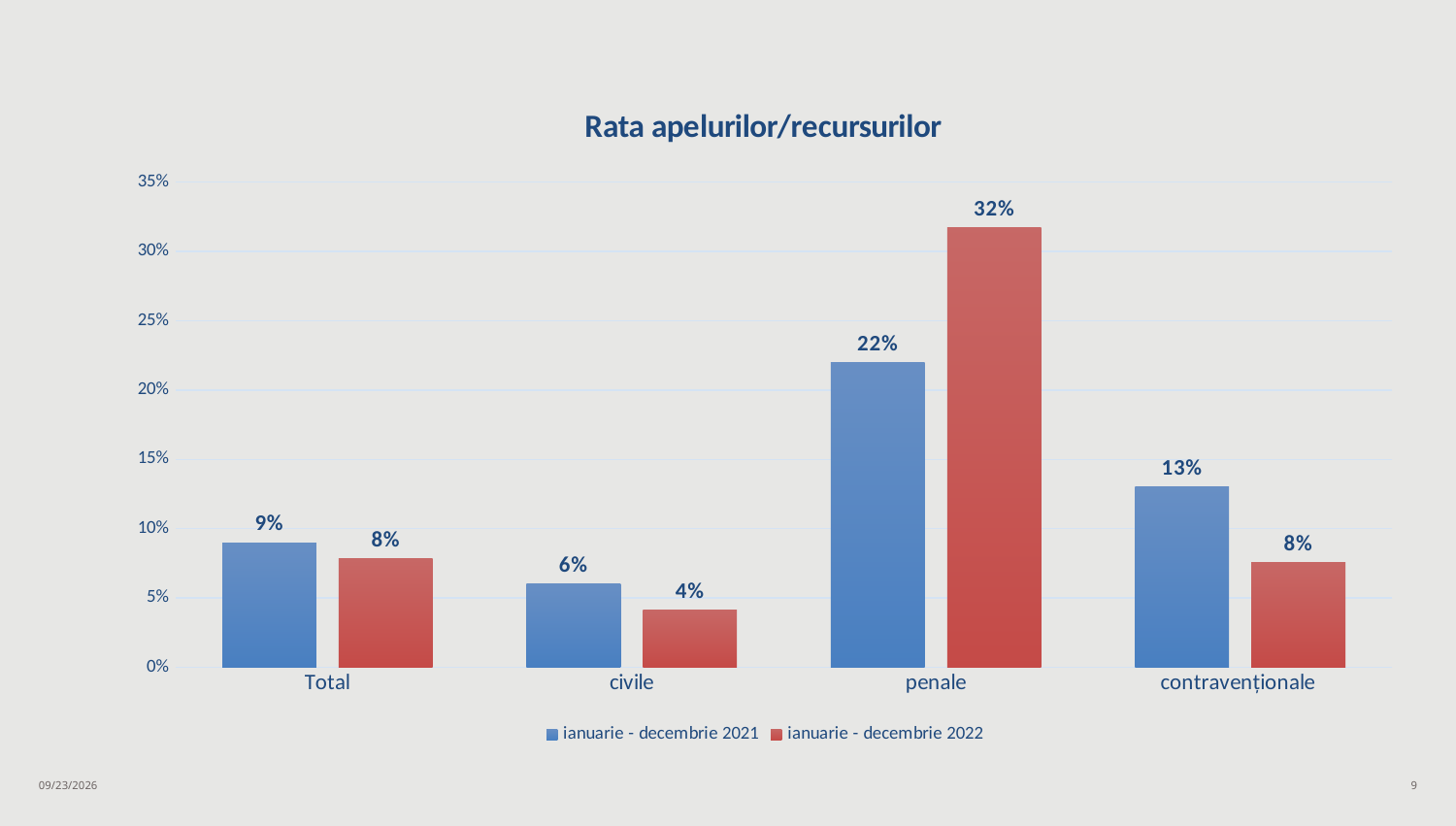
What is the value for civile in the ianuarie - decembrie 2021 series? 6% How many series does the legend list? 2 What is the title of the chart? Rata apelurilor/recursurilor What is the value for contravenționale in the ianuarie - decembrie 2021 series? 13% How many categories are shown on the x axis? 4 Which category has the lowest value in the ianuarie - decembrie 2021 series? civile Which is larger for contravenționale: the ianuarie - decembrie 2021 value or the ianuarie - decembrie 2022 value? ianuarie - decembrie 2021 What kind of chart is shown on the slide? bar chart Is the value for penale in the ianuarie - decembrie 2022 series greater or less than 30%? greater What is the value for penale in the ianuarie - decembrie 2022 series? 32% What is the difference between the ianuarie - decembrie 2022 and ianuarie - decembrie 2021 values for penale? 10% Which category has the highest value in the ianuarie - decembrie 2022 series? penale